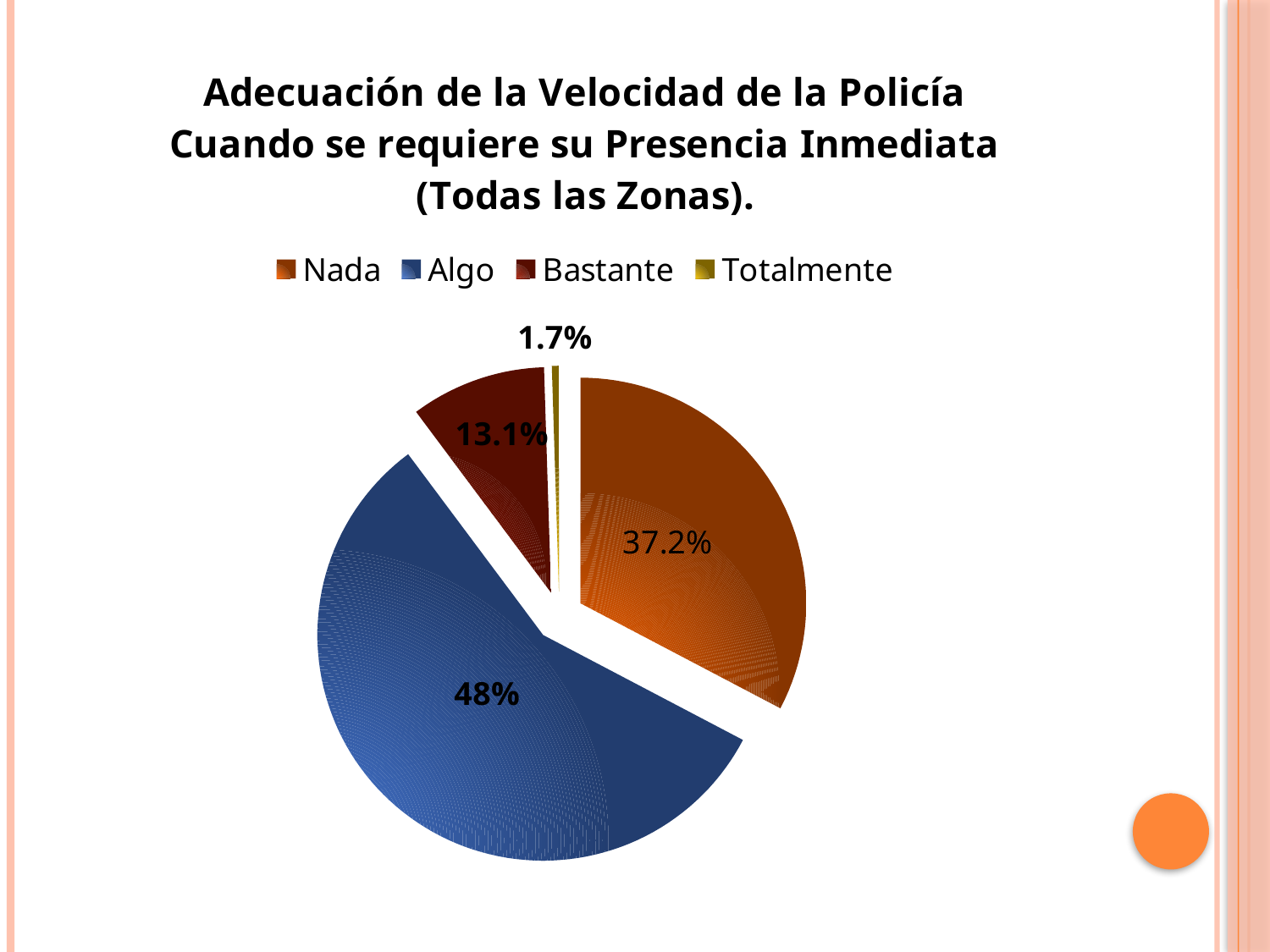
How many slices does the pie chart have? 4 What is the value for Algo? 48% What is the value for Totalmente? 1.7% How many categories does the legend list? 4 Which category has the smallest share of the pie? Totalmente What type of chart is shown on the slide? pie chart What colour is the slice for Algo? blue What is the value for Bastante? 13.1% Which is larger, the value for Nada or the value for Bastante? Nada What is the difference between the values for Algo and Nada? 10.8% Which category has the largest share of the pie? Algo What is the value for Nada? 37.2%